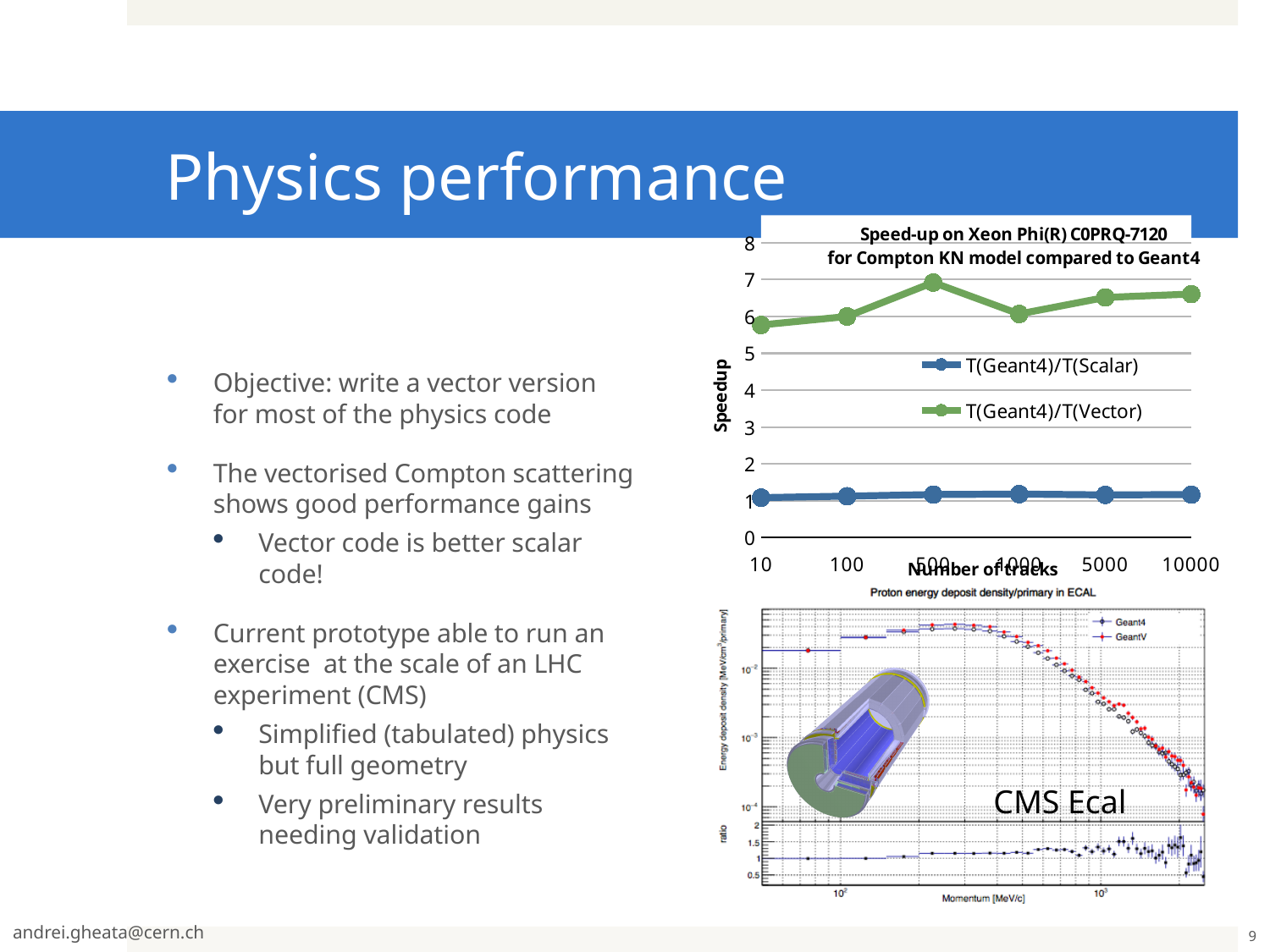
How many data points are plotted along the x axis for each series in the 'Speed-up on Xeon Phi(R) C0PRQ-7120' chart? 6 How many series does the legend of the 'Speed-up on Xeon Phi(R) C0PRQ-7120' chart list? 2 In the 'Speed-up on Xeon Phi(R) C0PRQ-7120' chart, is the T(Geant4)/T(Vector) value at 10000 tracks greater or less than 6? greater In the 'Speed-up on Xeon Phi(R) C0PRQ-7120' chart, is the T(Geant4)/T(Scalar) value at 1000 tracks greater or less than 2? less In the 'Speed-up on Xeon Phi(R) C0PRQ-7120' chart, is the T(Geant4)/T(Vector) value at 500 tracks greater or less than 6? greater What kind of chart is the 'Speed-up on Xeon Phi(R) C0PRQ-7120' chart at the top right? line chart In the 'Proton energy deposit density/primary in ECAL' chart at the bottom right, does the energy deposit density rise or fall as momentum increases beyond about 10^3 MeV/c? fall In the 'Speed-up on Xeon Phi(R) C0PRQ-7120' chart, which series has the higher value at 1000 tracks, T(Geant4)/T(Scalar) or T(Geant4)/T(Vector)? T(Geant4)/T(Vector) In the 'Speed-up on Xeon Phi(R) C0PRQ-7120' chart, at which number of tracks does the T(Geant4)/T(Vector) series reach its highest speedup? 500 In the 'Speed-up on Xeon Phi(R) C0PRQ-7120' chart, what is the label of the y axis? Speedup In the 'Speed-up on Xeon Phi(R) C0PRQ-7120' chart, what colour is the T(Geant4)/T(Vector) line? green How many series does the legend of the 'Proton energy deposit density/primary in ECAL' chart at the bottom right list? 2